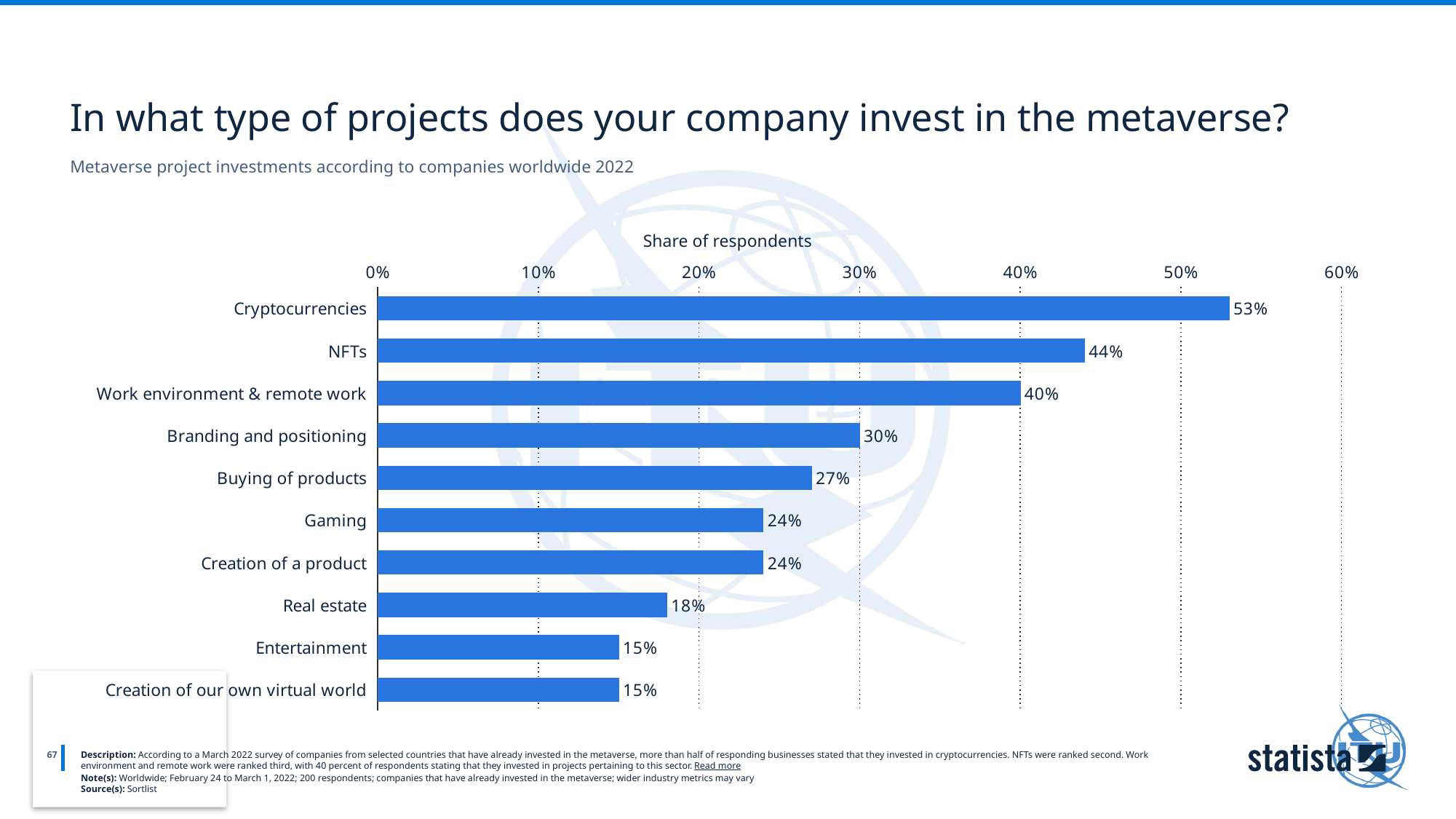
What share of respondents invest in cryptocurrencies? 53% Is the value for NFTs greater or less than 40%? greater Which category has the lowest share of respondents, Entertainment or Real estate? Entertainment What kind of chart is shown on the slide? Bar chart What is the difference between the values for Cryptocurrencies and NFTs? 9% Which category has the highest share of respondents? Cryptocurrencies What is the difference between Branding and positioning and Buying of products? 3% How many categories are shown in the chart? 10 Which is larger, the value for Gaming or the value for Real estate? Gaming What is the value for Work environment & remote work? 40% What is the label of the horizontal axis? Share of respondents What share of respondents invest in Real estate? 18%